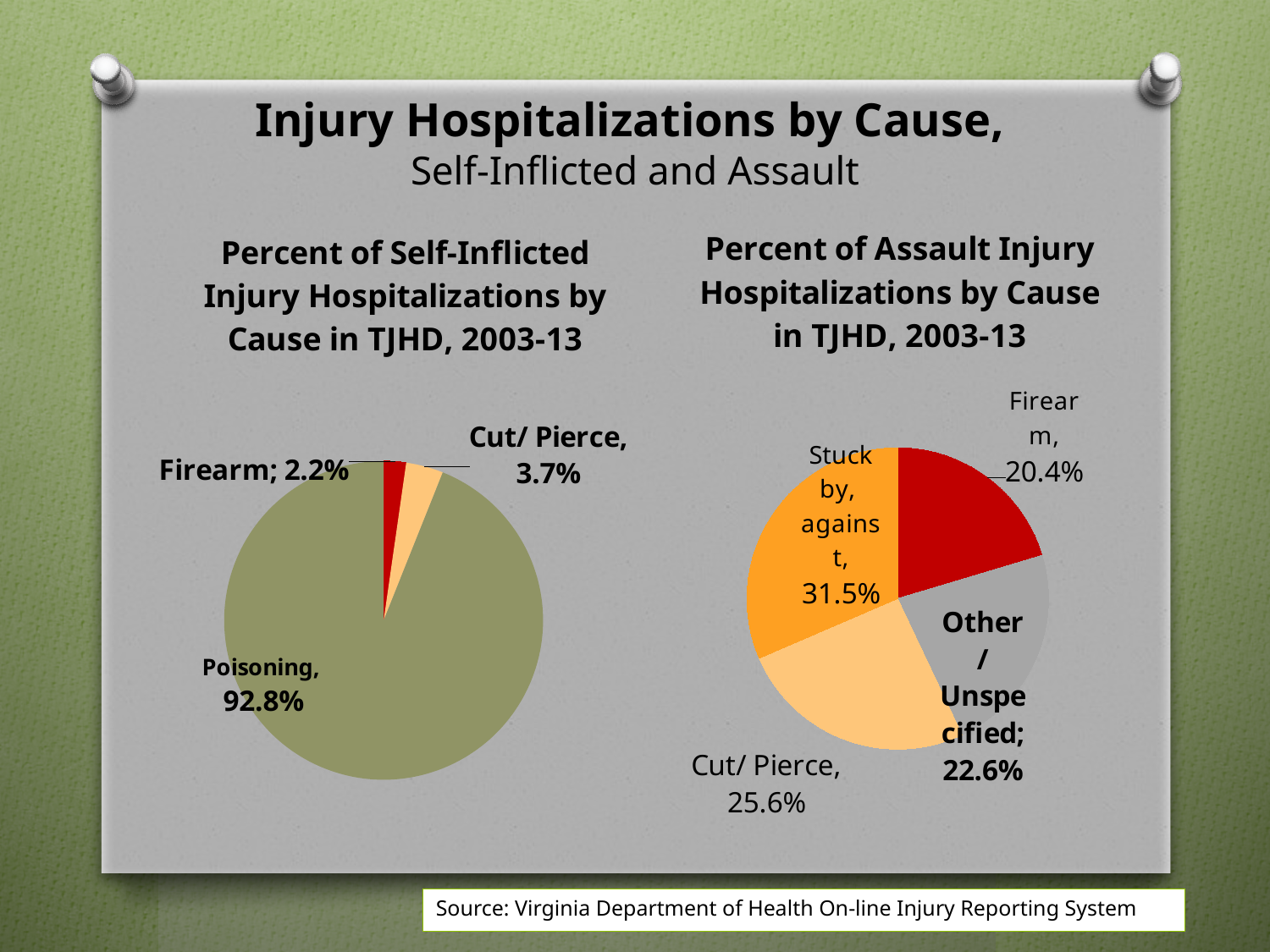
In the 'Percent of Assault Injury Hospitalizations by Cause in TJHD, 2003-13' chart, what percentage is Stuck by, against? 31.5% What type of chart is used for the 'Percent of Self-Inflicted Injury Hospitalizations by Cause in TJHD, 2003-13' chart? Pie chart In the 'Percent of Assault Injury Hospitalizations by Cause in TJHD, 2003-13' chart, which is larger, Other/Unspecified or Firearm? Other/Unspecified In the 'Percent of Assault Injury Hospitalizations by Cause in TJHD, 2003-13' chart, which cause has the largest share? Stuck by, against In the 'Percent of Assault Injury Hospitalizations by Cause in TJHD, 2003-13' chart, what percentage is Cut/ Pierce? 25.6% In the 'Percent of Self-Inflicted Injury Hospitalizations by Cause in TJHD, 2003-13' chart, which cause has the smallest share? Firearm In the 'Percent of Assault Injury Hospitalizations by Cause in TJHD, 2003-13' chart, how many slices does the pie have? 4 In the 'Percent of Self-Inflicted Injury Hospitalizations by Cause in TJHD, 2003-13' chart, what is the difference between Cut/ Pierce and Firearm? 1.5% In the 'Percent of Self-Inflicted Injury Hospitalizations by Cause in TJHD, 2003-13' chart, what percentage is Poisoning? 92.8% In the 'Percent of Self-Inflicted Injury Hospitalizations by Cause in TJHD, 2003-13' chart, what percentage is Firearm? 2.2% In the 'Percent of Assault Injury Hospitalizations by Cause in TJHD, 2003-13' chart, which cause has the smallest share? Firearm In the 'Percent of Self-Inflicted Injury Hospitalizations by Cause in TJHD, 2003-13' chart, which cause has the largest share? Poisoning